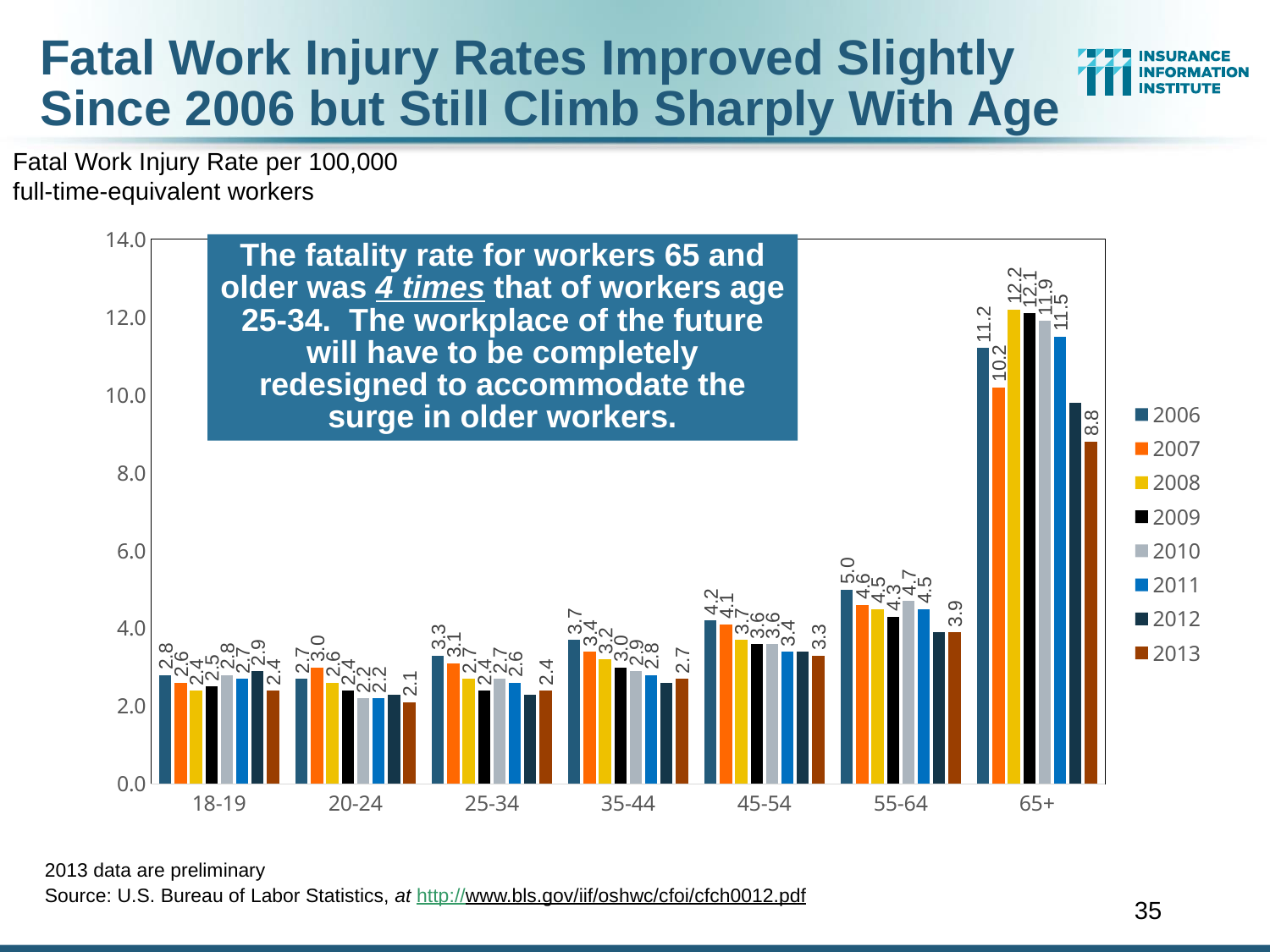
Which age group has the highest fatal work injury rates? 65+ How many series (years) does the legend list? 8 Which age group has the lowest 2013 fatal work injury rate? 20-24 What is the 2013 fatal work injury rate for workers aged 65+? 8.8 What is the 2007 fatal work injury rate for workers aged 65+? 10.2 In 2007, which age group had the larger rate: 18-19 or 20-24? 20-24 Is the 2012 value for workers aged 35-44 greater or less than 3.0? less What kind of chart is shown on the slide? bar chart What is the 2006 fatal work injury rate for workers aged 55-64? 5.0 How many age groups are shown on the x axis? 7 What is the difference between the 2008 and 2013 rates for workers aged 65+? 3.4 From the 25-34 group to the 65+ group, do the 2006 values rise or fall? rise